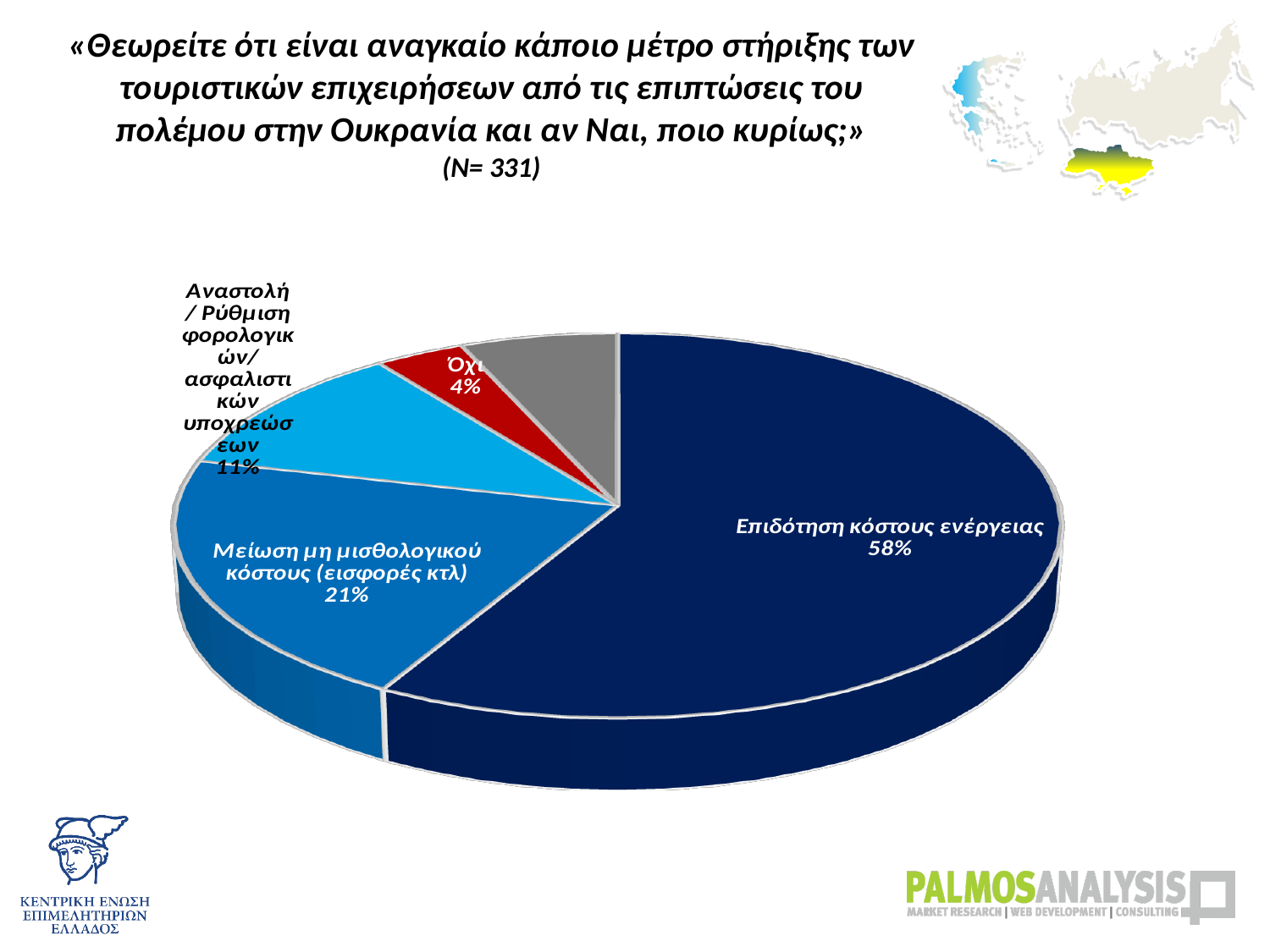
Which labelled response has the smallest share of the pie? Όχι What percentage of respondents chose «Επιδότηση κόστους ενέργειας»? 58% What is the combined share of the four labelled slices? 94% What percentage is shown for «Αναστολή / Ρύθμιση φορολογικών/ασφαλιστικών υποχρεώσεων»? 11% How many slices does the pie chart have? 5 Which is larger: the share for «Μείωση μη μισθολογικού κόστους» or the share for «Αναστολή / Ρύθμιση φορολογικών/ασφαλιστικών υποχρεώσεων»? Μείωση μη μισθολογικού κόστους Which response has the largest share of the pie? Επιδότηση κόστους ενέργειας What percentage is shown for «Μείωση μη μισθολογικού κόστους (εισφορές κτλ)»? 21% What is the sample size (N) stated under the chart title? 331 How many percentage points larger is «Επιδότηση κόστους ενέργειας» than «Μείωση μη μισθολογικού κόστους (εισφορές κτλ)»? 37 percentage points What percentage of respondents answered «Όχι»? 4% What kind of chart is shown on the slide? Pie chart